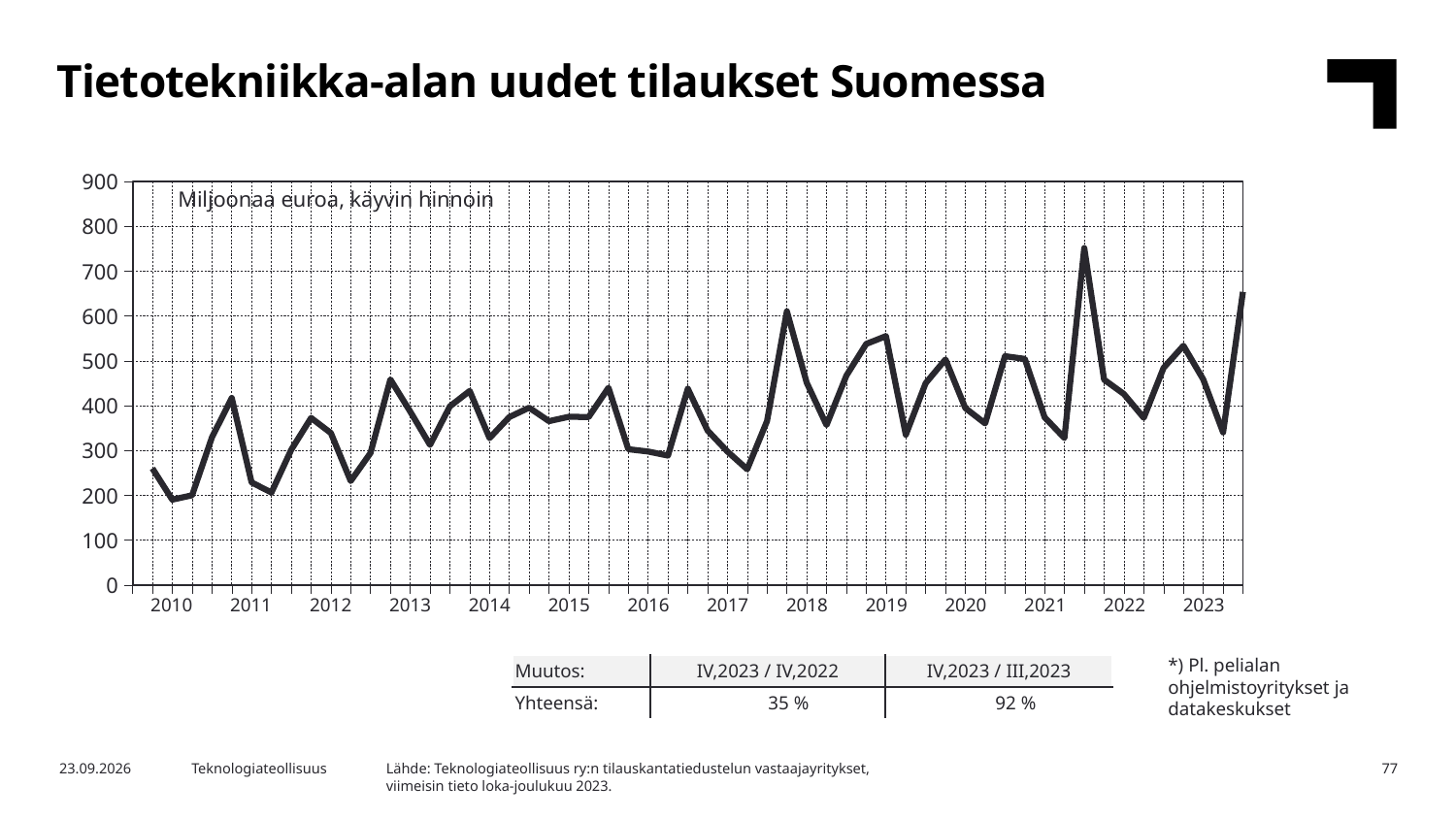
Which is higher: the peak of the line in 2021 or the peak in 2018? 2021 In which year does the line reach its highest peak? 2021 Is the highest peak of the line, in 2021, greater or less than 700? greater What kind of chart is shown on the slide? line chart Is the first value of the line, at the start of 2010, greater or less than 300? less What is the title of the chart on the slide? Tietotekniikka-alan uudet tilaukset Suomessa In which unit are the values on the chart expressed, according to the label inside the plot area? Miljoonaa euroa, käyvin hinnoin Is the peak of the line in 2018 greater or less than 500? greater Overall, do the values of the line rise or fall from 2010 to 2023? rise How many years are labelled on the x axis of the chart? 14 What is the highest value shown on the y axis of the chart? 900